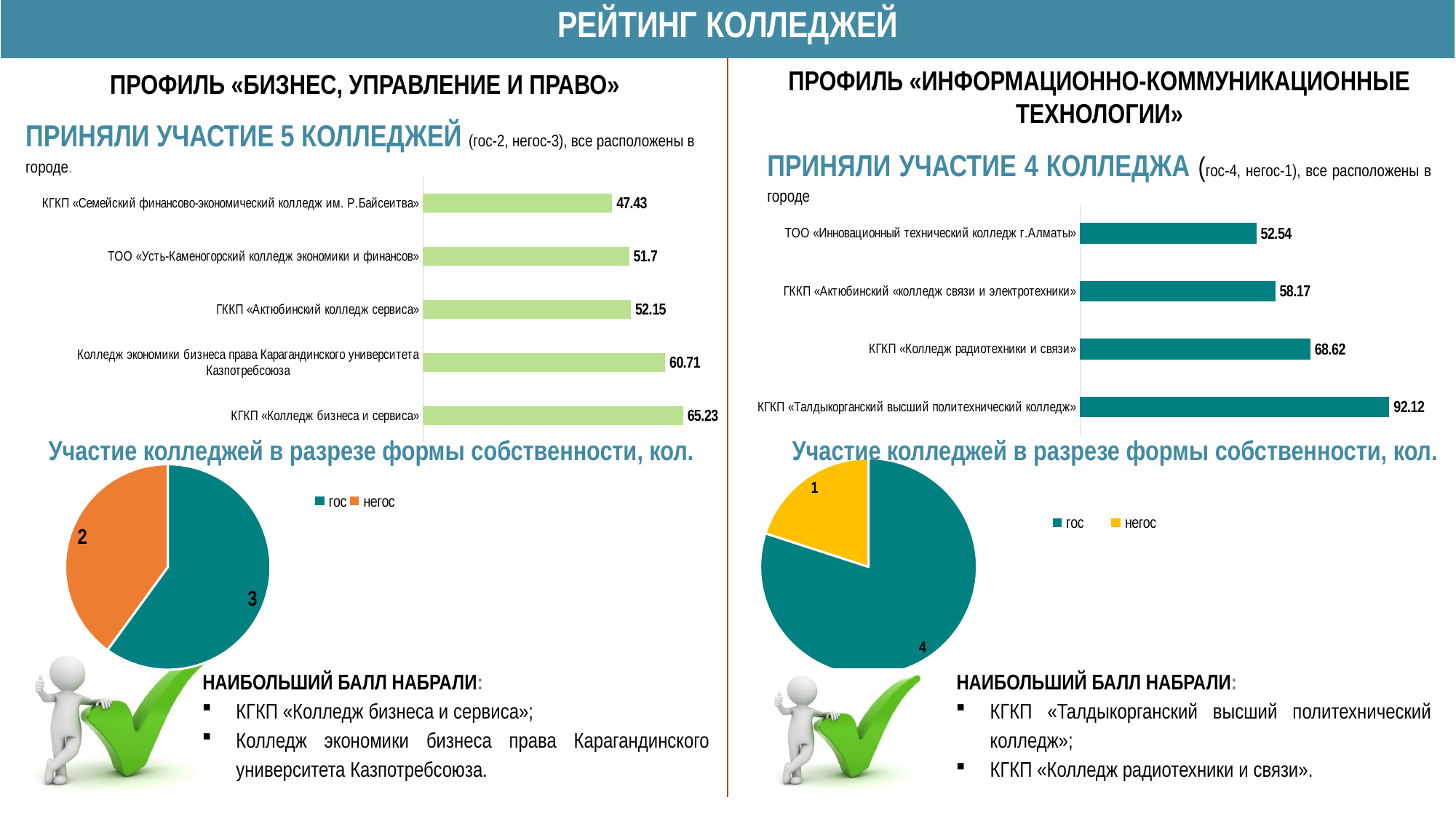
In the bar chart under «Бизнес, управление и право», which college has the lowest value? КГКП «Семейский финансово-экономический колледж им. Р.Байсеитва» In the bar chart under «Информационно-коммуникационные технологии», which college has the highest value? КГКП «Талдыкорганский высший политехнический колледж» What type of chart is used to show the college scores on the left side of the slide? Bar chart In the pie chart on the right side of the slide, what is the value of the негос slice? 1 In the bar chart under «Информационно-коммуникационные технологии», what is the difference between the values for КГКП «Колледж радиотехники и связи» and ТОО «Инновационный технический колледж г.Алматы»? 16.08 In the pie chart on the right side of the slide, what share of the total does the гос slice represent? 80% In the bar chart under «Информационно-коммуникационные технологии», what is the value for КГКП «Талдыкорганский высший политехнический колледж»? 92.12 In the bar chart under «Бизнес, управление и право», what is the value for ТОО «Усть-Каменогорский колледж экономики и финансов»? 51.7 In the bar chart under «Информационно-коммуникационные технологии», which is larger: the value for ГККП «Актюбинский «колледж связи и электротехники» or for ТОО «Инновационный технический колледж г.Алматы»? ГККП «Актюбинский «колледж связи и электротехники» In the bar chart under «Бизнес, управление и право», what is the value for КГКП «Колледж бизнеса и сервиса»? 65.23 In the bar chart under «Бизнес, управление и право», what is the difference between the values for КГКП «Колледж бизнеса и сервиса» and ГККП «Актюбинский колледж сервиса»? 13.08 How many colleges are shown in the bar chart under «Бизнес, управление и право»? 5